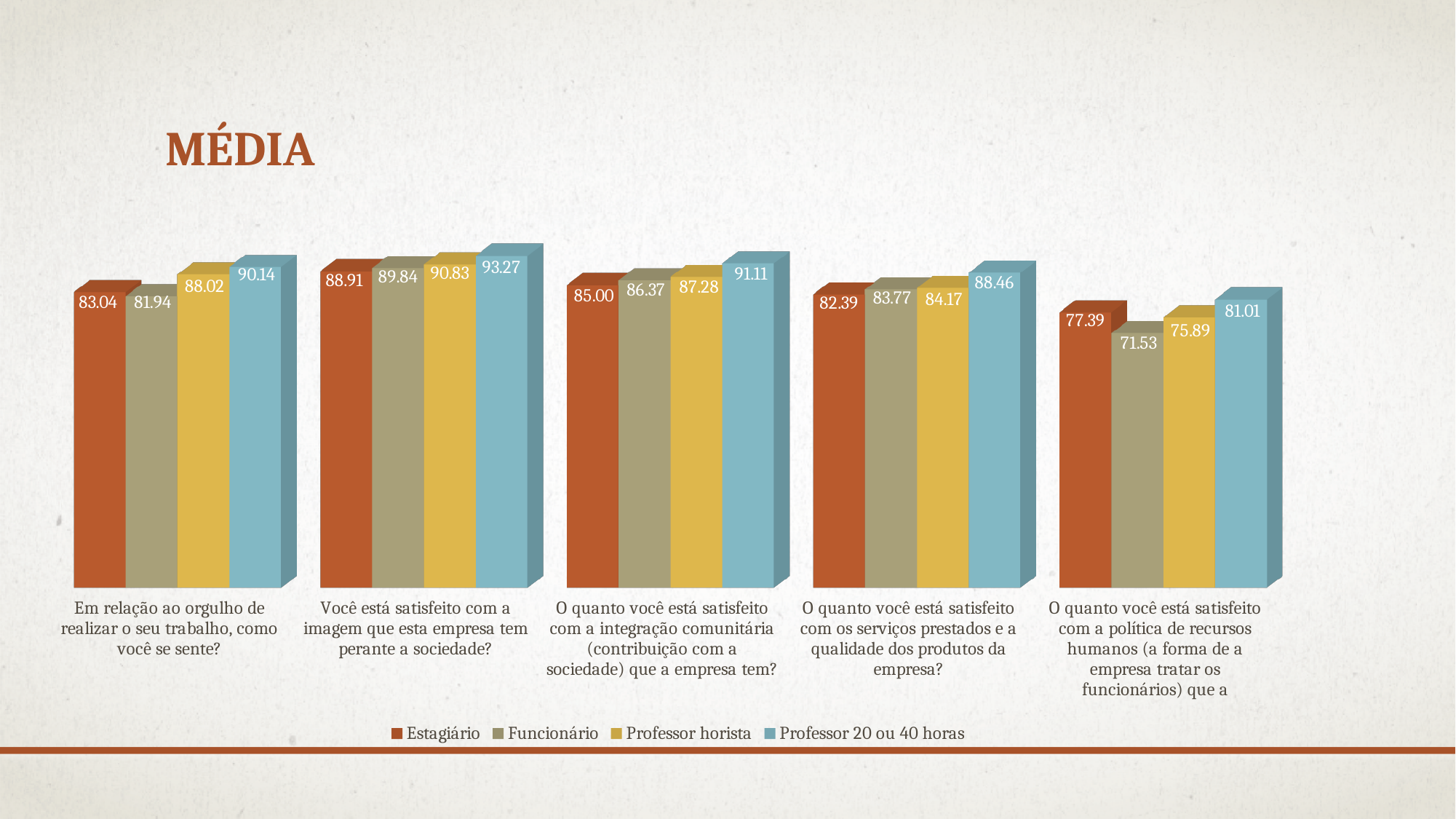
Which series has the lowest value in the category "O quanto você está satisfeito com a política de recursos humanos"? Funcionário Which category has the lowest Professor horista value? O quanto você está satisfeito com a política de recursos humanos What is the title of the chart? MÉDIA What is the value for Funcionário in the category "O quanto você está satisfeito com a política de recursos humanos"? 71.53 How many question categories are shown along the x axis? 5 In the category "Em relação ao orgulho de realizar o seu trabalho", which is larger: the Estagiário value or the Funcionário value? Estagiário How many series does the legend list? 4 What is the difference between the Professor 20 ou 40 horas value and the Estagiário value in the category "O quanto você está satisfeito com os serviços prestados e a qualidade dos produtos da empresa?"? 6.07 What is the value for Professor 20 ou 40 horas in the category "Você está satisfeito com a imagem que esta empresa tem perante a sociedade?"? 93.27 What kind of chart is shown on the slide? Bar chart What is the value for Estagiário in the category "Em relação ao orgulho de realizar o seu trabalho, como você se sente?"? 83.04 Which series has the highest value in the category "O quanto você está satisfeito com a integração comunitária"? Professor 20 ou 40 horas